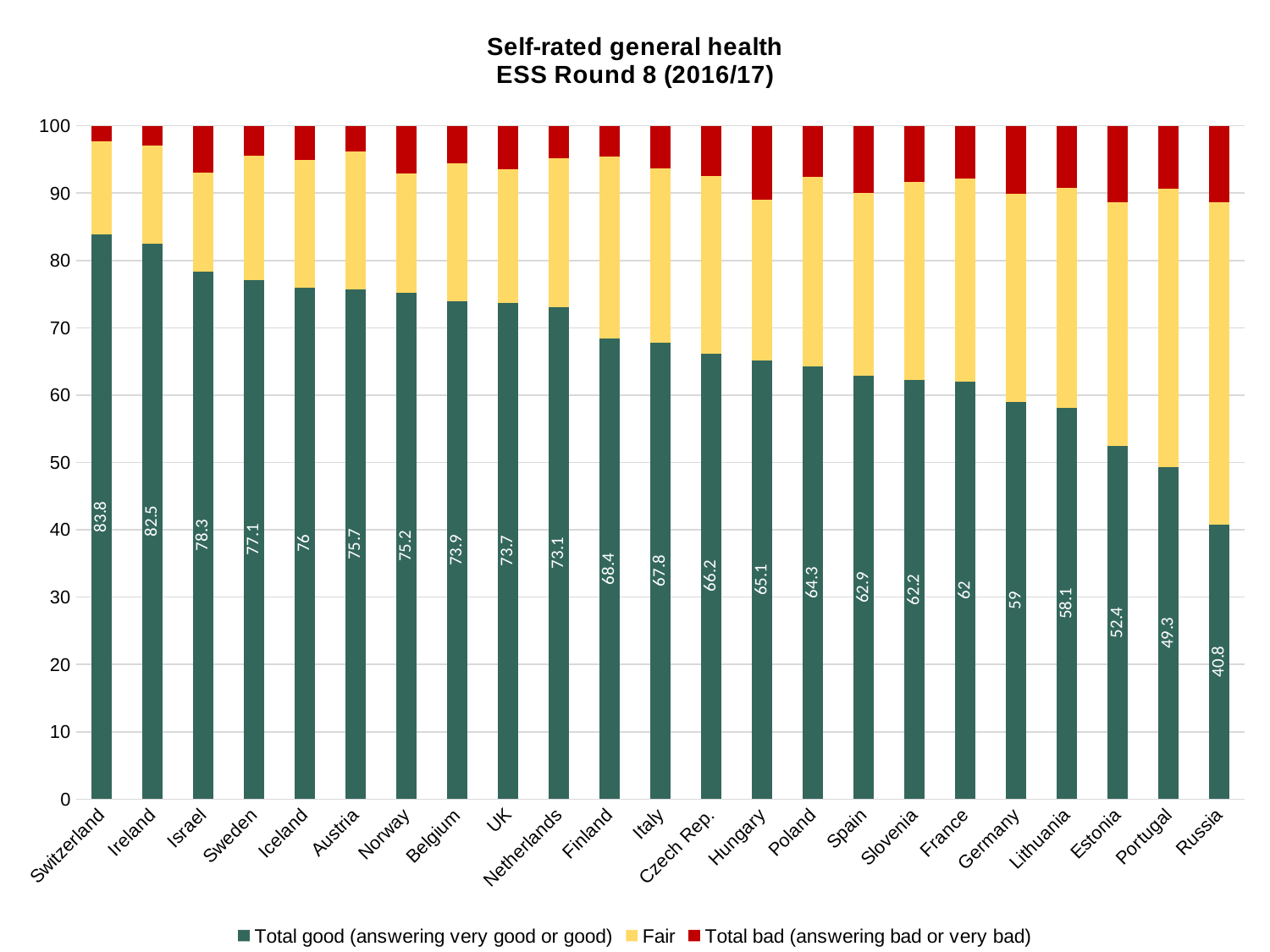
What is the Total good value for Hungary? 65.1 Is the combined Total good plus Fair value for Switzerland greater or less than 95? greater What is the Total good value for Portugal? 49.3 What is the Total good value for Switzerland? 83.8 Which has a larger Total good value, Finland or Germany? Finland Which country has the highest Total good value? Switzerland What kind of chart is this? Stacked bar chart How many series does the legend list? 3 Which country has the lowest Total good value? Russia How many countries are shown on the x axis? 23 Do the Total good values rise or fall from left to right along the x axis? Fall What is the difference between the Total good values for Switzerland and Russia? 43